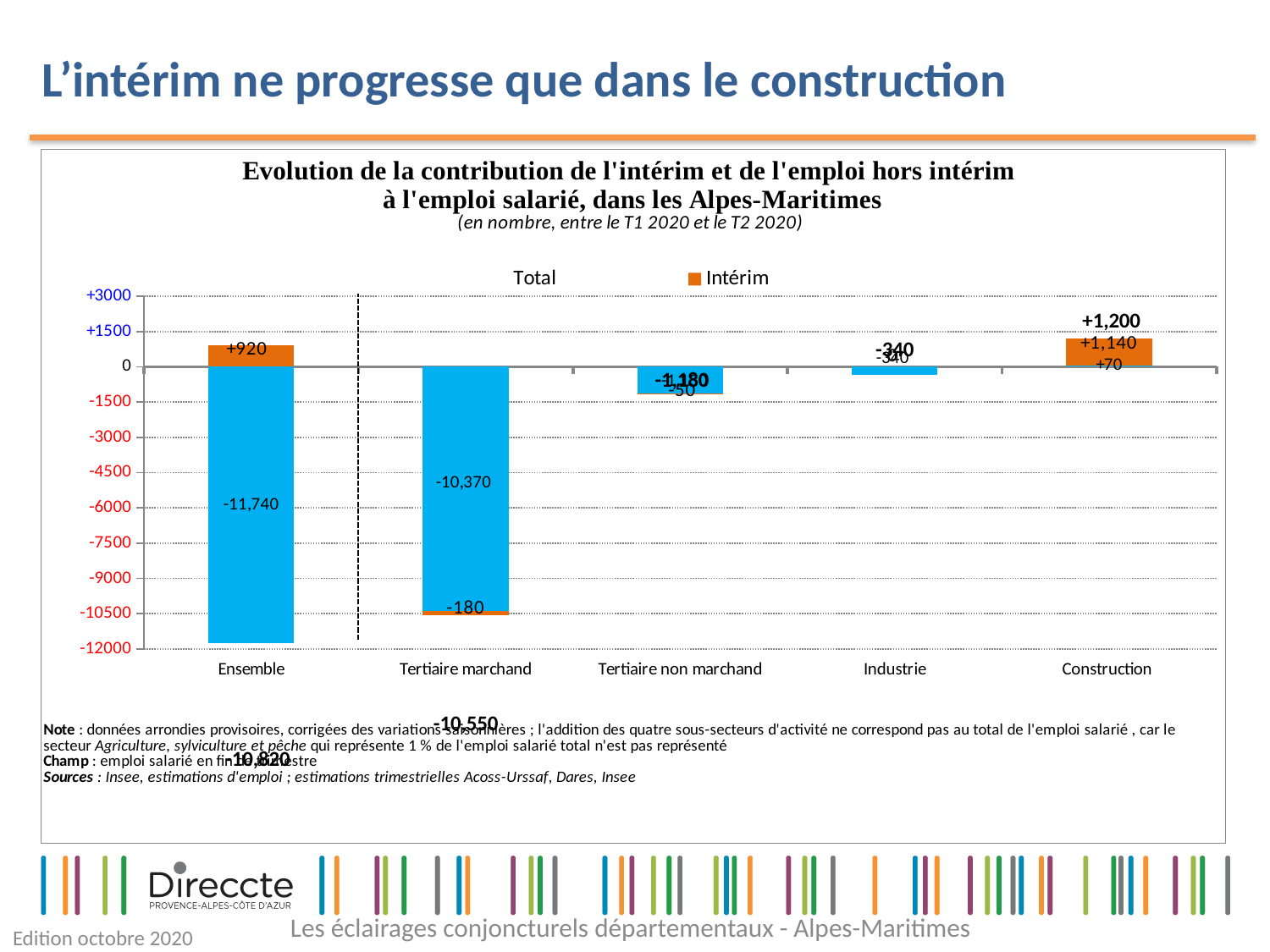
How many categories are shown along the x axis of the chart? 5 What is the value of the blue bar for Tertiaire marchand? -10,370 What is the value of the blue bar for Construction? +70 What type of chart is shown on the slide? Bar chart What is the difference between the blue bar for Ensemble (-11,740) and the blue bar for Tertiaire marchand (-10,370)? 1,370 Which category has the lowest blue bar? Ensemble What is the value of the orange Intérim bar for Ensemble? +920 Which two entries does the chart legend list? Total and Intérim Which is lower, the blue bar for Ensemble or the blue bar for Tertiaire marchand? Ensemble What is the Total value shown for Construction? +1,200 What is the value of the blue bar for Ensemble? -11,740 What is the value of the orange Intérim bar for Tertiaire marchand? -180